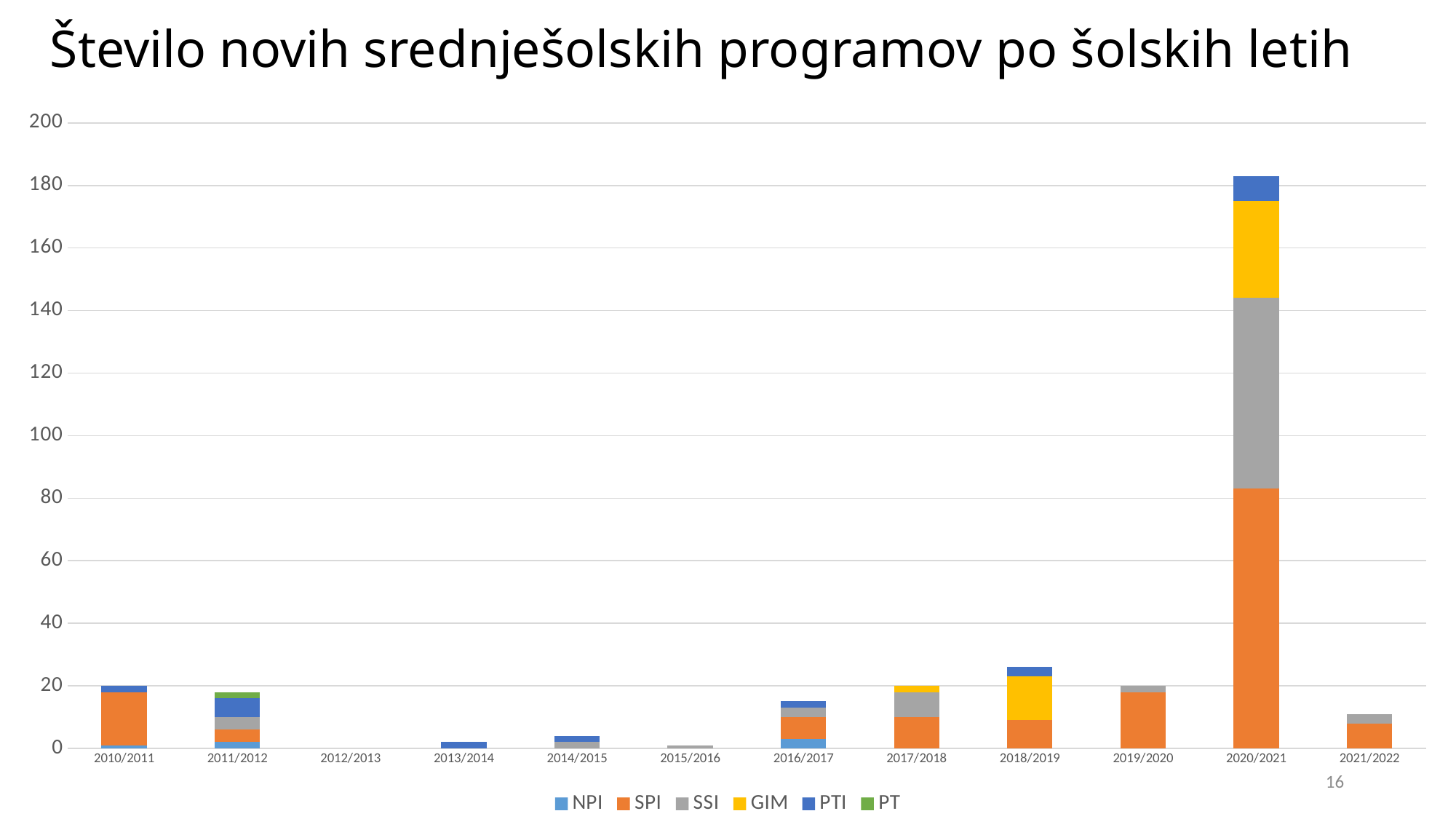
Is the total for 2016/2017 greater or less than 20? less What kind of chart is shown on the slide? stacked bar chart Which series is shown in orange in the legend? SPI How many school years (categories) are shown on the x axis? 12 Which school year has the lowest total, with no visible bar at all? 2012/2013 Is the total for 2020/2021 greater or less than 160? greater Which school year has the highest total number of new programmes? 2020/2021 How many series does the legend list? 6 Is the total for 2018/2019 greater or less than 20? greater What is the title of the chart? Število novih srednješolskih programov po šolskih letih Which has the larger total, 2018/2019 or 2016/2017? 2018/2019